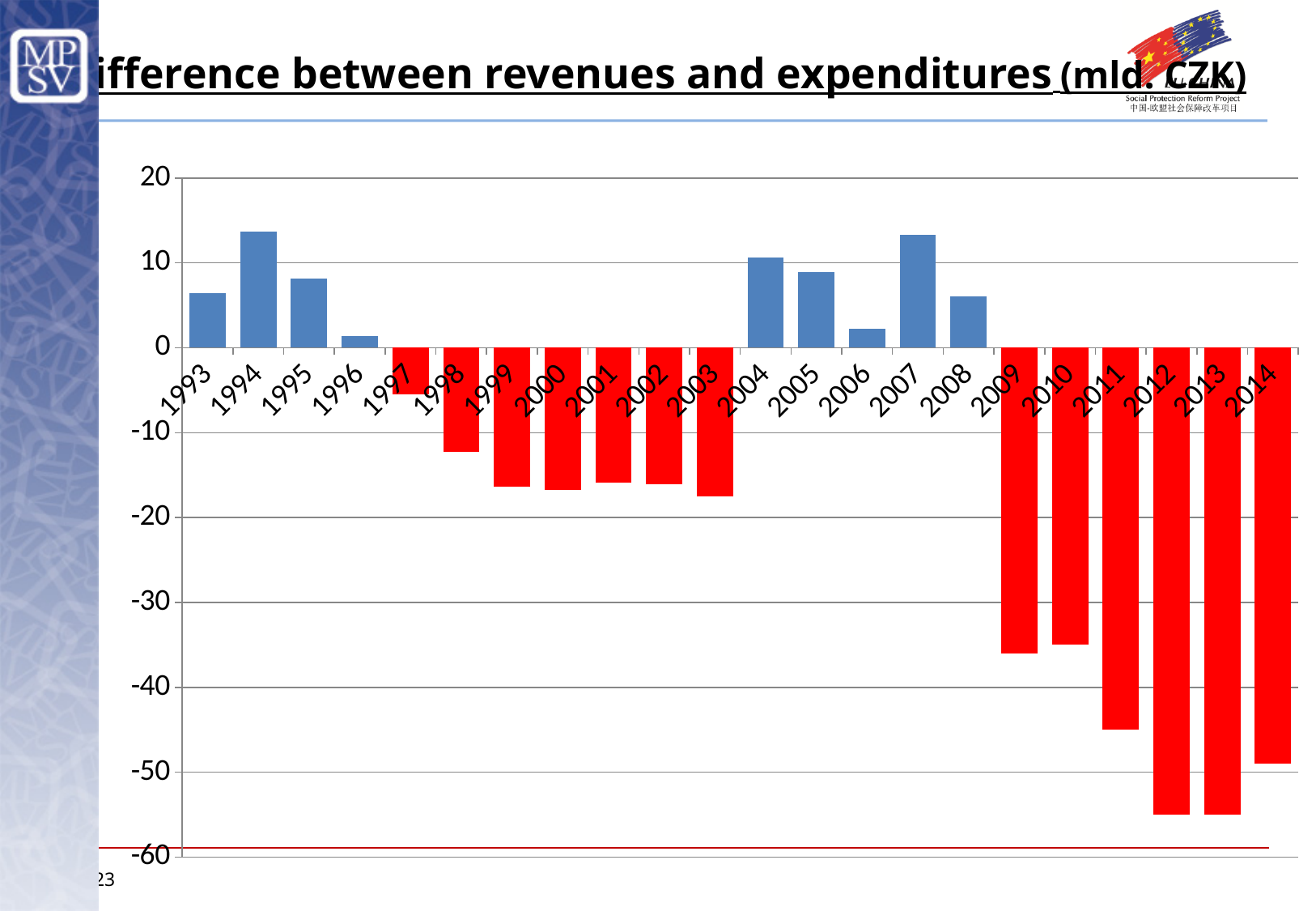
Is the value for 1998 greater or less than -10? less Is the value for 2011 greater or less than -40? less Is the value for 1994 greater or less than 10? greater Which year has the larger value, 2010 or 2011? 2010 What kind of chart is shown on the slide? bar chart Which year has the larger value, 1993 or 1995? 1995 What colour are the bars with negative values? red Do the values rise or fall from 2009 to 2012? fall How many years are shown on the x axis of the chart? 22